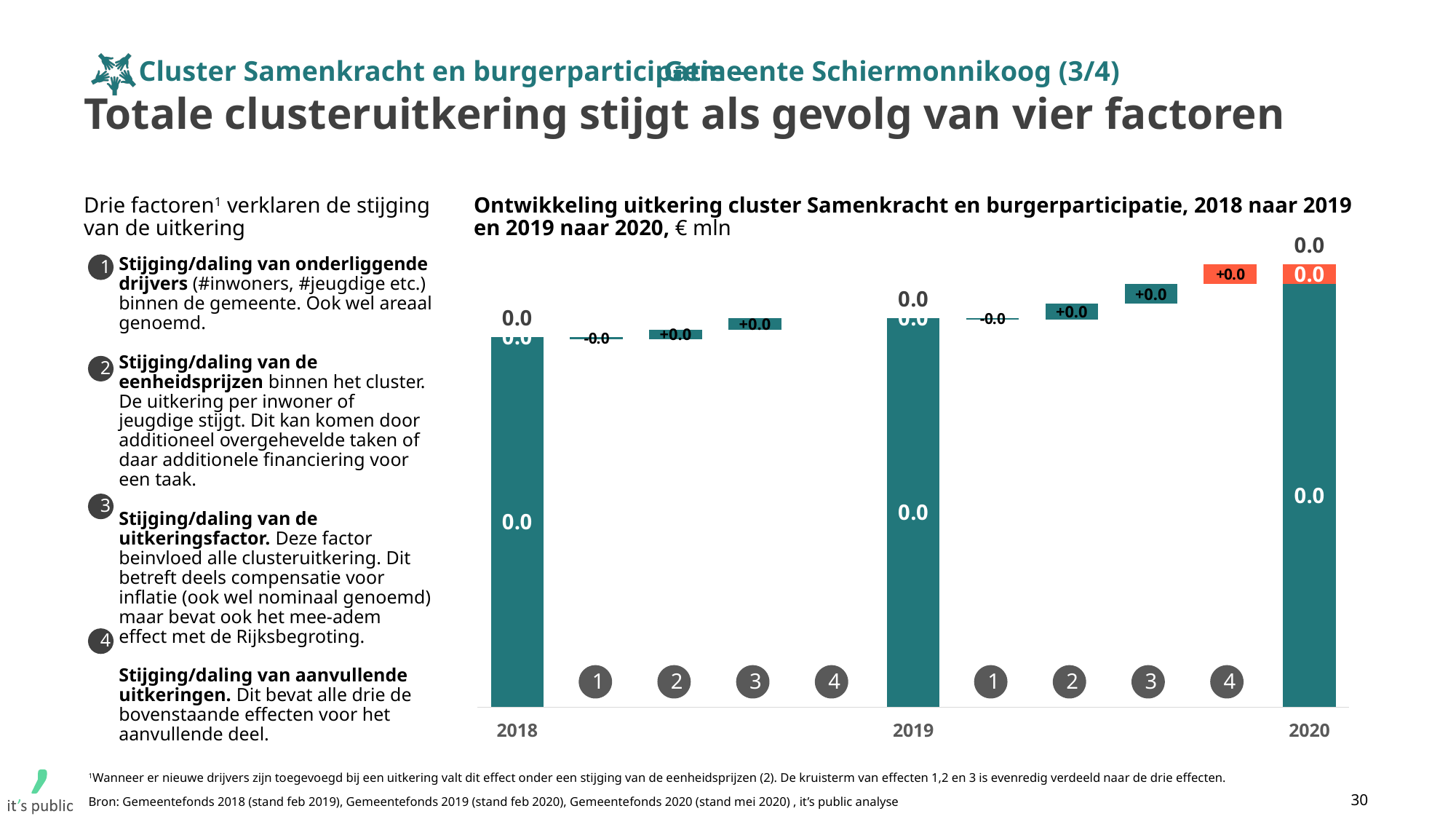
How many numbered factor steps are shown between 2018 and 2019? 4 What is the data label on factor 4 between 2019 and 2020? +0.0 What is the difference between the 2020 total and the 2018 total? 0.0 What is the data label on factor 1 between 2018 and 2019? -0.0 What is the data label on the 2019 total bar? 0.0 What is the data label on factor 2 between 2019 and 2020? +0.0 What is the data label on the 2020 total bar? 0.0 What kind of chart is shown on the slide? bar chart How many years are shown as total bars on the x axis? 3 Which factor step is shown in orange rather than teal? 4 In what unit are the chart values expressed? € mln What is the data label on the 2018 total bar? 0.0